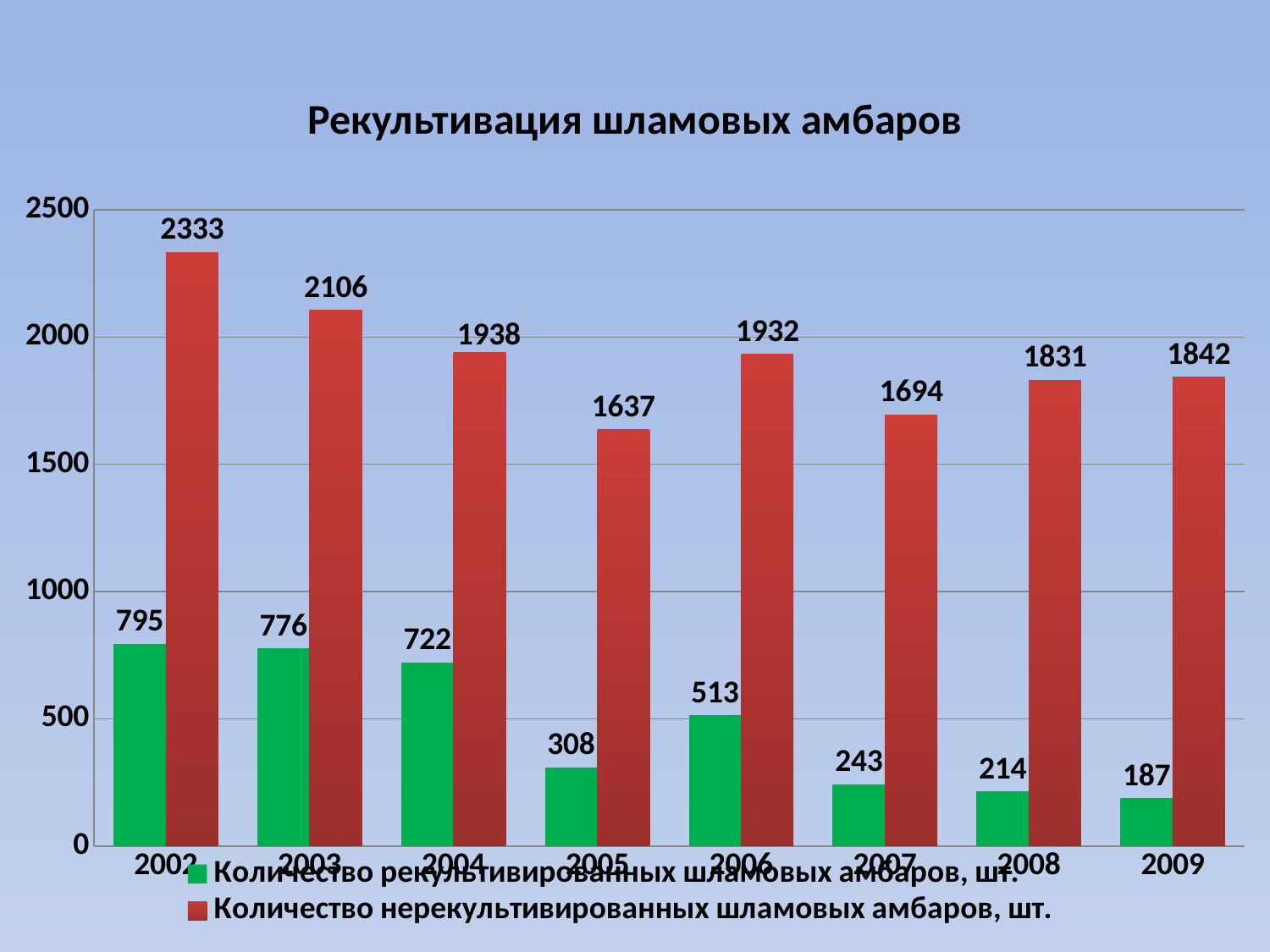
How many series does the legend list? 2 How many years are shown on the x axis? 8 In which year is Количество рекультивированных шламовых амбаров the lowest? 2009 What is the difference between Количество нерекультивированных шламовых амбаров in 2002 and in 2003? 227 What is the value of Количество рекультивированных шламовых амбаров in 2005? 308 What type of chart is shown on the slide? bar chart What is the title of the chart? Рекультивация шламовых амбаров Which colour represents Количество нерекультивированных шламовых амбаров in the chart? red Does Количество рекультивированных шламовых амбаров generally rise or fall from 2002 to 2009? fall What is the value of Количество нерекультивированных шламовых амбаров in 2007? 1694 Which is larger: Количество рекультивированных шламовых амбаров in 2004 or in 2006? 2004 In which year is Количество нерекультивированных шламовых амбаров the highest? 2002